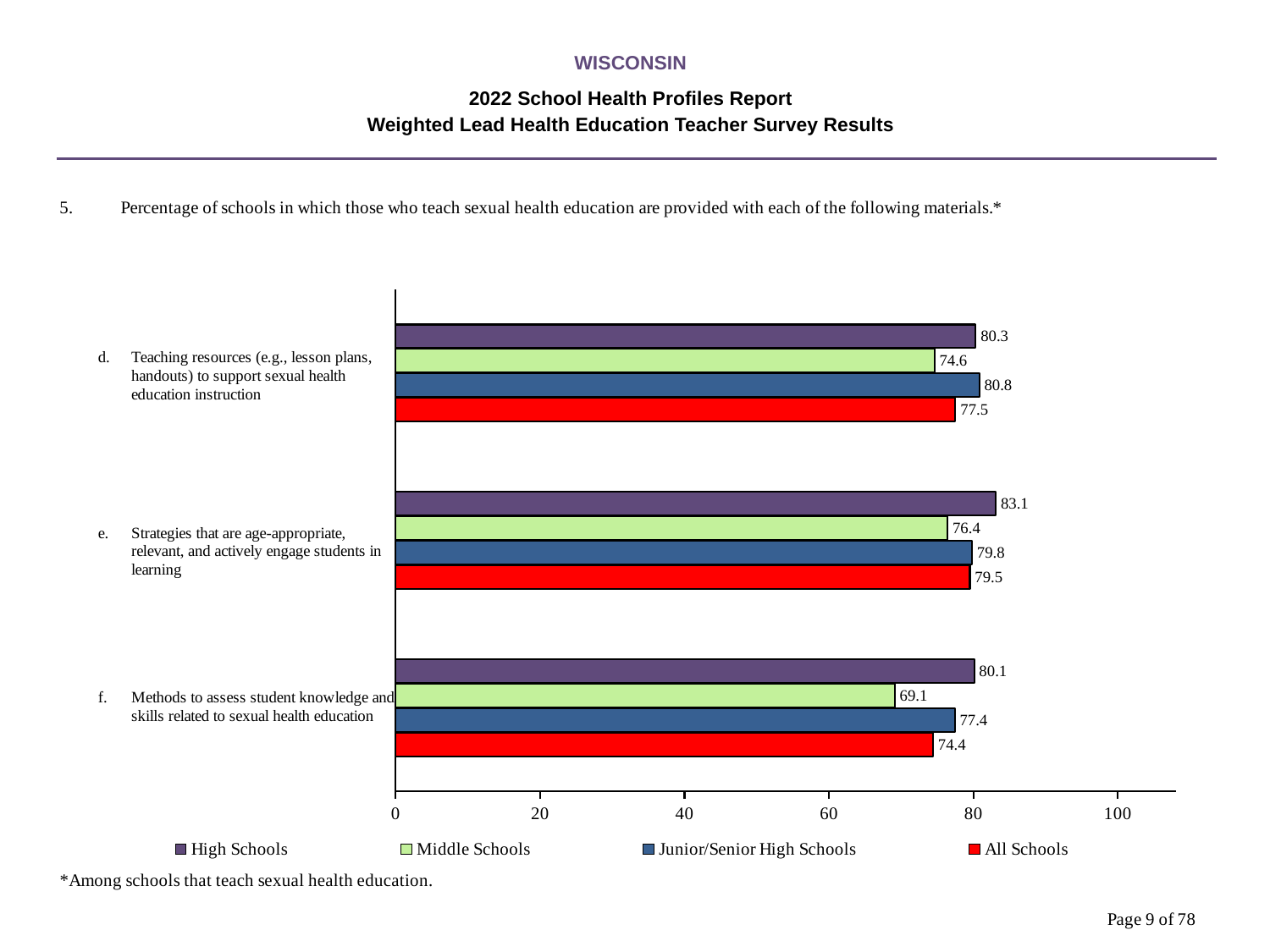
What is the value for Middle Schools for 'Methods to assess student knowledge and skills related to sexual health education'? 69.1 What is the value for All Schools for 'Teaching resources (e.g., lesson plans, handouts) to support sexual health education instruction'? 77.5 Which school type has the lowest value for 'Methods to assess student knowledge and skills related to sexual health education'? Middle Schools Which is larger for 'Teaching resources (e.g., lesson plans, handouts) to support sexual health education instruction': the High Schools value or the Junior/Senior High Schools value? Junior/Senior High Schools What is the value for Junior/Senior High Schools for 'Methods to assess student knowledge and skills related to sexual health education'? 77.4 What kind of chart is shown on the slide? Bar chart What colour represents All Schools in the legend? Red Which school type has the highest value for 'Strategies that are age-appropriate, relevant, and actively engage students in learning'? High Schools How many material categories are shown on the chart? 3 What is the value for High Schools for 'Strategies that are age-appropriate, relevant, and actively engage students in learning'? 83.1 How many series does the legend list? 4 What is the difference between the High Schools and Middle Schools values for 'Methods to assess student knowledge and skills related to sexual health education'? 11.0